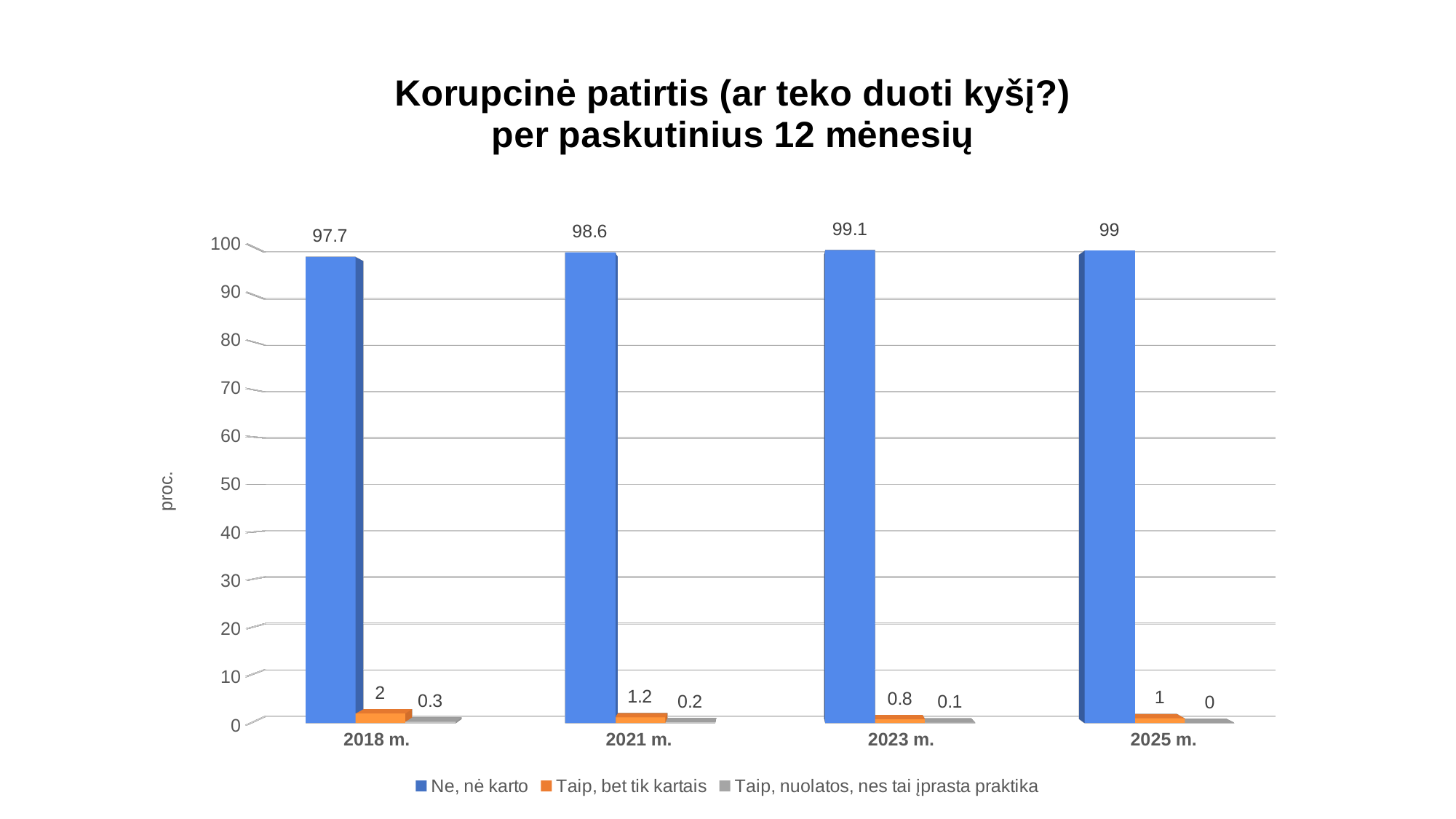
Which is larger: the "Taip, bet tik kartais" value in 2018 m. or in 2025 m.? 2018 m. What is the value for "Ne, nė karto" in 2023 m.? 99.1 What is the value for "Taip, bet tik kartais" in 2021 m.? 1.2 How many years are shown on the x axis? 4 What is the value for "Ne, nė karto" in 2018 m.? 97.7 What is the value for "Taip, nuolatos, nes tai įprasta praktika" in 2025 m.? 0 How many series does the legend list? 3 In which year is the value for "Taip, bet tik kartais" lowest? 2023 m. In which year is the value for "Ne, nė karto" highest? 2023 m. What kind of chart is shown on the slide? Bar chart What is the difference between the "Ne, nė karto" values for 2023 m. and 2018 m.? 1.4 Does the value for "Taip, bet tik kartais" rise or fall from 2018 m. to 2023 m.? Fall